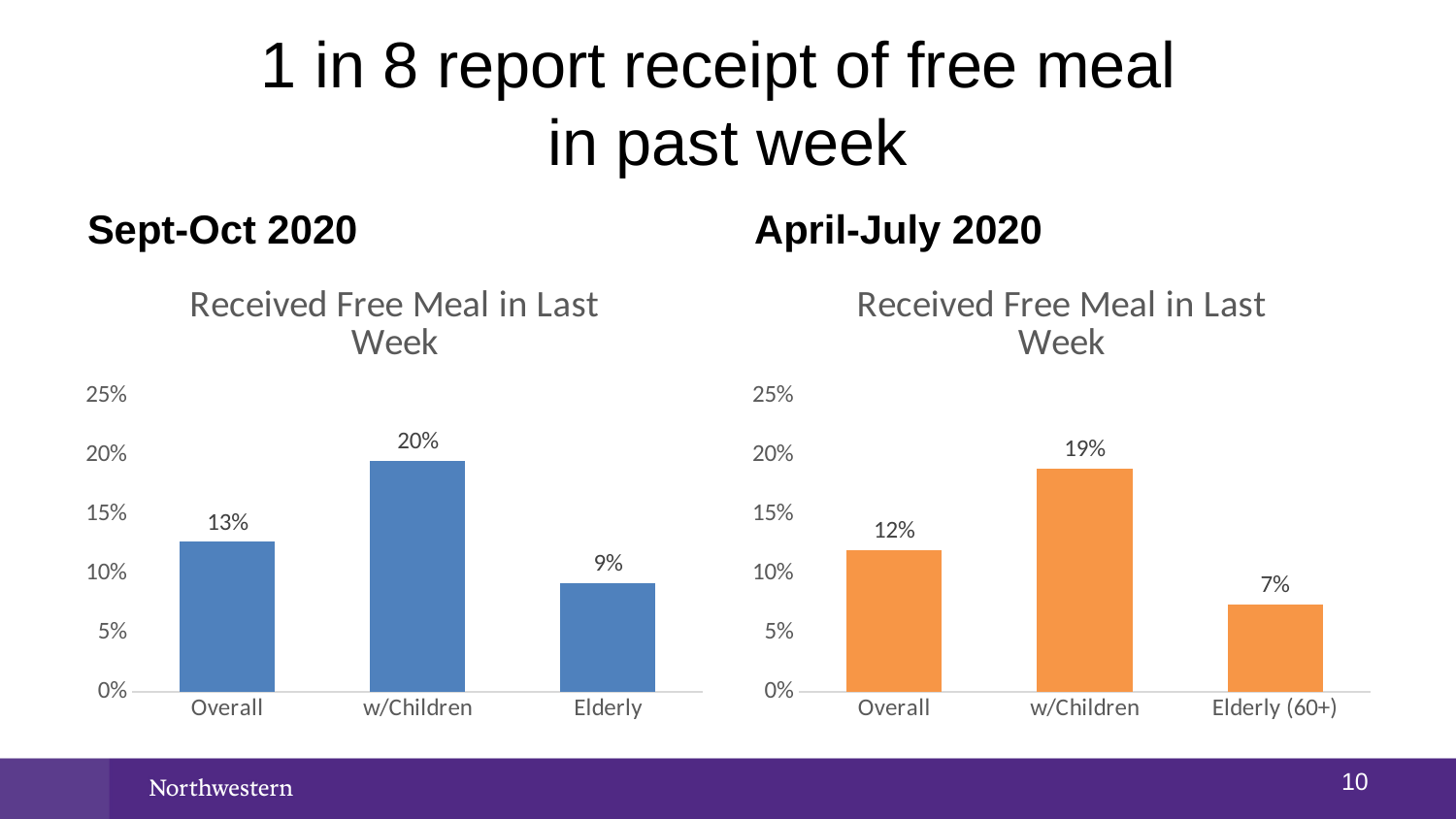
In the April-July 2020 chart on the right, what is the difference between the Overall and Elderly (60+) values? 5% In the April-July 2020 chart on the right, is the value for w/Children greater or less than 15%? greater What colour are the bars in the April-July 2020 chart on the right? Orange Which is larger: the Overall value in the Sept-Oct 2020 chart or the Overall value in the April-July 2020 chart? Sept-Oct 2020 In the April-July 2020 chart on the right, which category has the highest value? w/Children In the Sept-Oct 2020 chart on the left, which category has the lowest value? Elderly What kind of chart is the April-July 2020 chart on the right? Bar chart In the Sept-Oct 2020 chart on the left, what is the value for Overall? 13% In the Sept-Oct 2020 chart on the left, what is the difference between the w/Children and Elderly values? 11% How many categories are shown in the Sept-Oct 2020 chart on the left? 3 In the April-July 2020 chart on the right, what is the value for Elderly (60+)? 7% In the Sept-Oct 2020 chart on the left, what is the value for w/Children? 20%